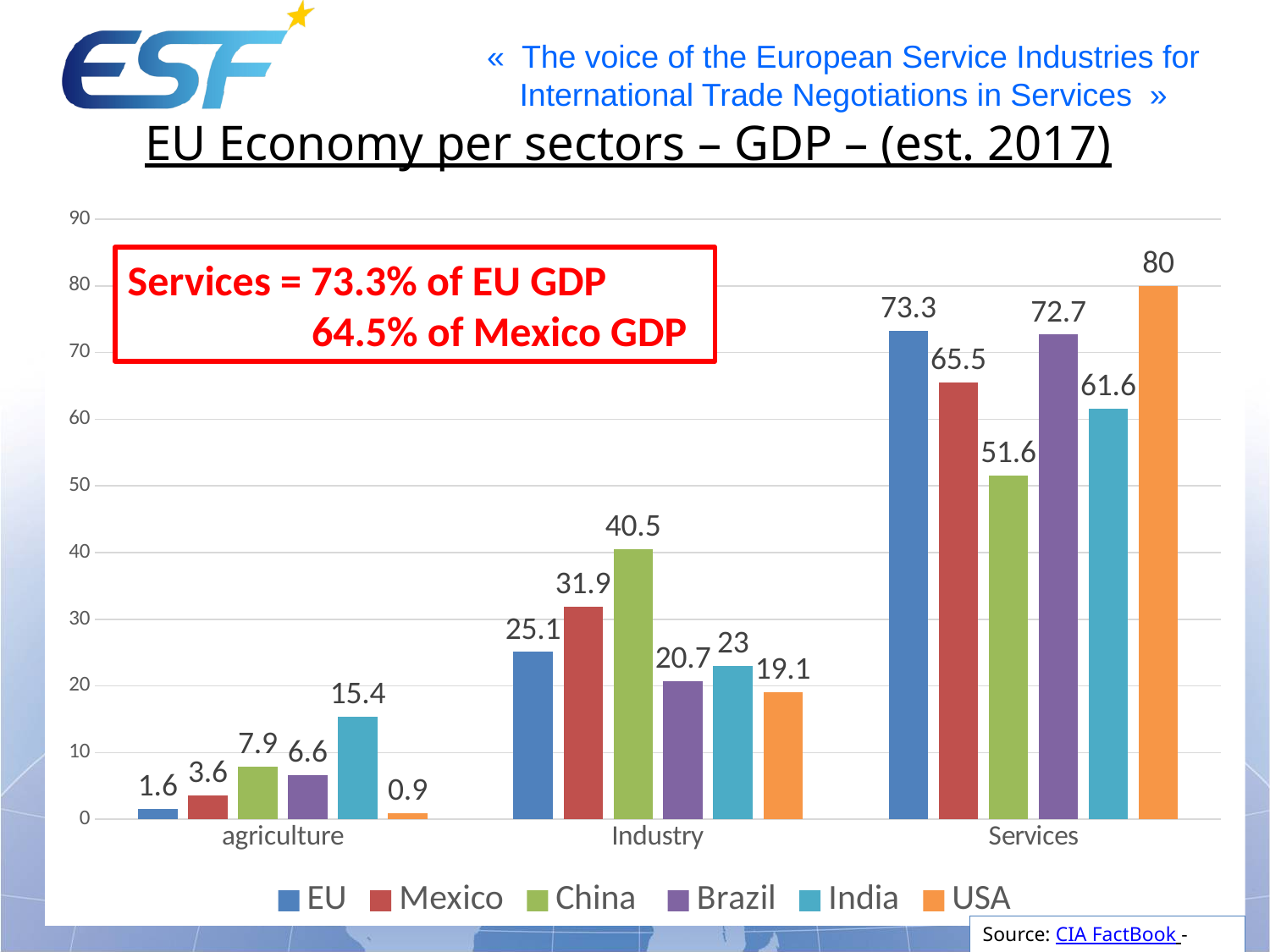
What kind of chart is shown on the slide? bar chart Which series has the highest value in the Services category? USA How many series does the legend list? 6 What is the title of the chart? EU Economy per sectors – GDP – (est. 2017) Which series has the lowest value in the agriculture category? USA What is the value for the EU in the Services category? 73.3 What is the difference between the USA and EU values in the Services category? 6.7 What is the value for India in the agriculture category? 15.4 Is the value for China in the Services category greater or less than 50? greater How many categories are shown on the x axis? 3 Which is larger in the Industry category, the value for Mexico or the value for Brazil? Mexico What is the value for China in the Industry category? 40.5